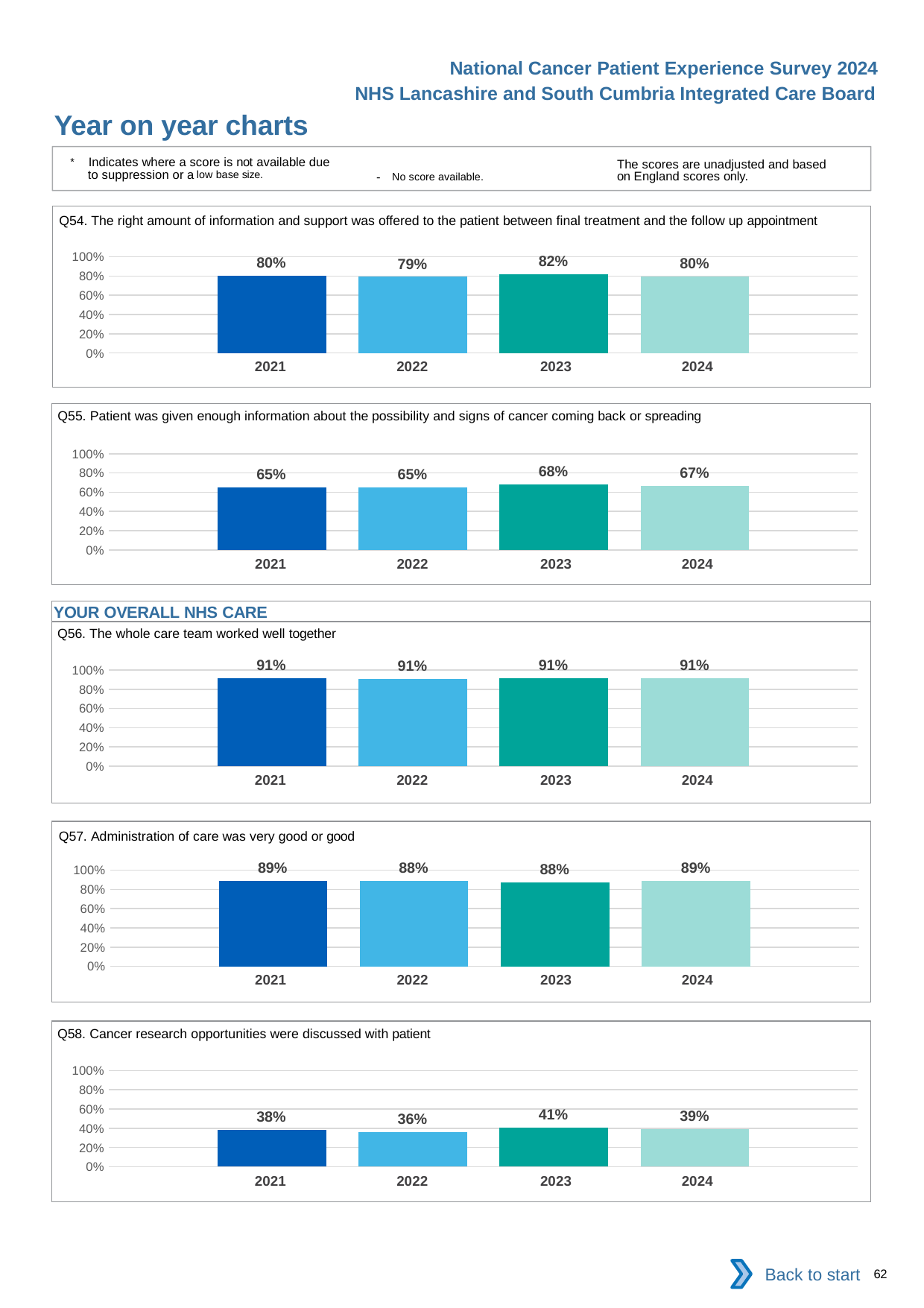
In the Q55 chart, what is the value for 2024? 67% In the Q58 chart, what is the difference between the 2023 value and the 2022 value? 5% In the Q54 chart, what is the value for 2023? 82% In the Q54 chart, what is the difference between the 2023 value and the 2022 value? 3% In the Q58 chart, is the value for 2024 greater or less than 60%? less What is the section heading shown above the Q56 chart? YOUR OVERALL NHS CARE In the Q58 chart, which year has the lowest value? 2022 What kind of chart is the Q57 chart? bar chart In the Q56 chart, do the values rise, fall or stay the same from 2021 to 2024? stay the same How many years are shown in the Q56 chart? 4 In the Q55 chart, which year has the highest value? 2023 In the Q57 chart, is the value for 2021 larger or smaller than the value for 2022? larger